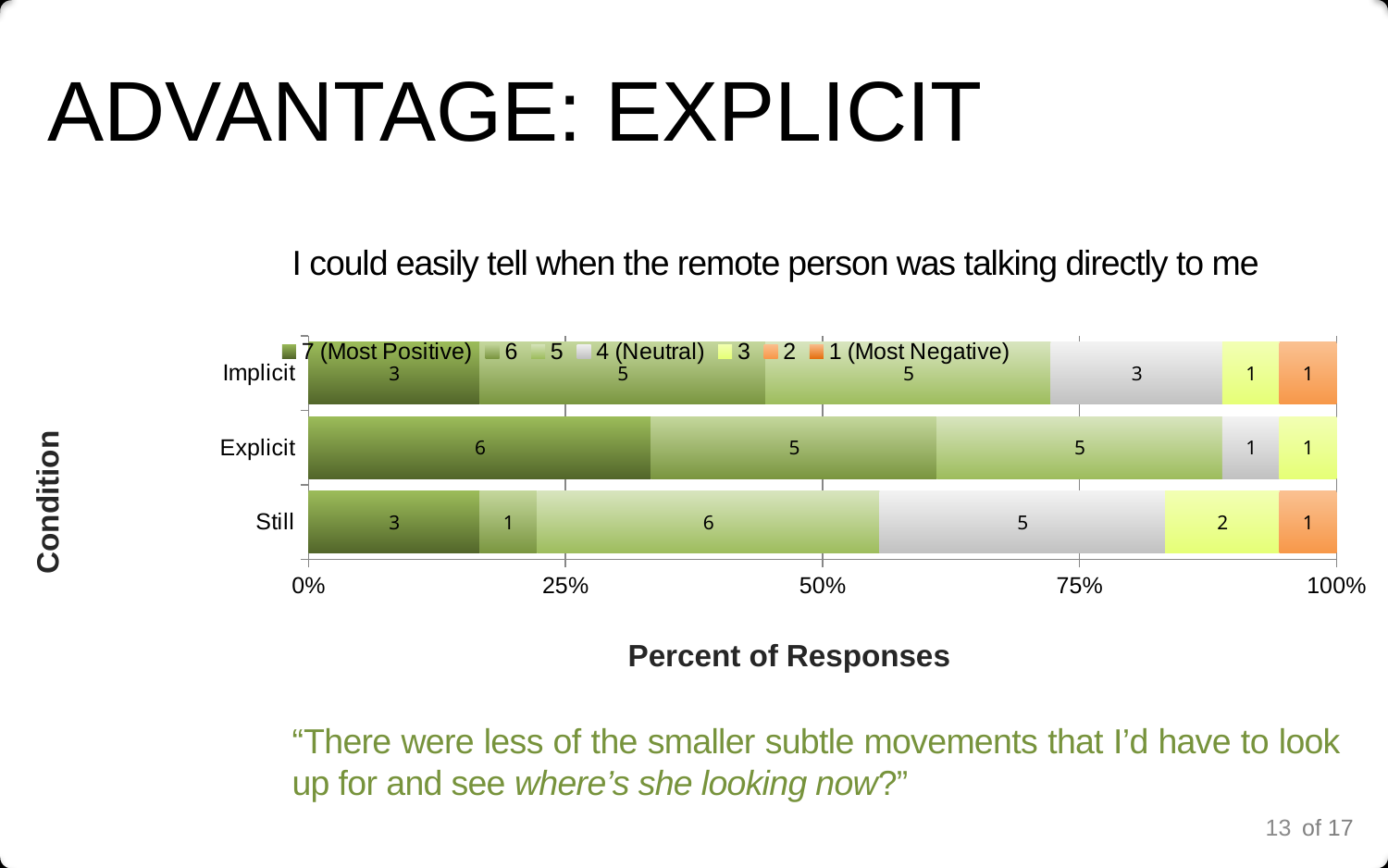
What is the count of 4 (Neutral) responses for the Still condition? 5 What is the count of 7 (Most Positive) responses for the Implicit condition? 3 How many series does the chart legend list? 7 How many conditions (categories) are shown on the y axis of the chart? 3 Which condition has the lowest count of 6 responses? Still What is the x-axis title of the chart? Percent of Responses What is the count of 5 responses for the Still condition? 6 What is the count of 7 (Most Positive) responses for the Explicit condition? 6 Which is larger: the 4 (Neutral) count for Still or for Explicit? Still What is the difference between the 7 (Most Positive) counts for Explicit and Implicit? 3 What type of chart is shown on the slide? stacked bar chart Which condition has the highest count of 7 (Most Positive) responses? Explicit